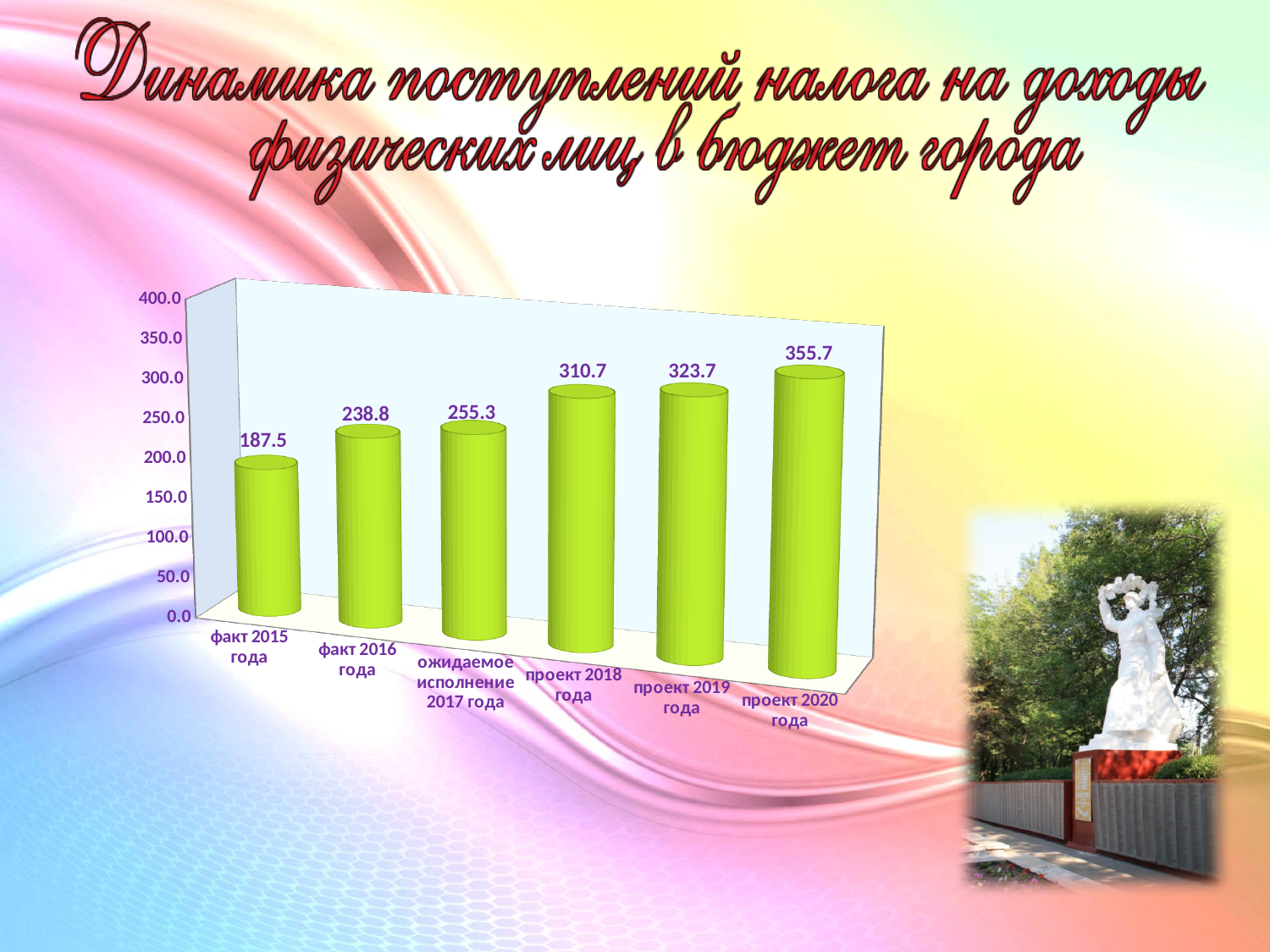
How many categories are shown on the chart? 6 What is the difference between the values for проект 2019 года and проект 2018 года? 13.0 Which category has the lowest value? факт 2015 года Do the values rise or fall from факт 2015 года to проект 2020 года? rise What is the value for ожидаемое исполнение 2017 года? 255.3 Is the value for проект 2019 года greater or less than 300.0? greater What is the difference between the values for проект 2020 года and факт 2015 года? 168.2 What is the value for факт 2015 года? 187.5 What kind of chart is shown on the slide? bar chart Which category has the highest value? проект 2020 года Which is larger, the value for факт 2016 года or the value for ожидаемое исполнение 2017 года? ожидаемое исполнение 2017 года What is the value for проект 2018 года? 310.7